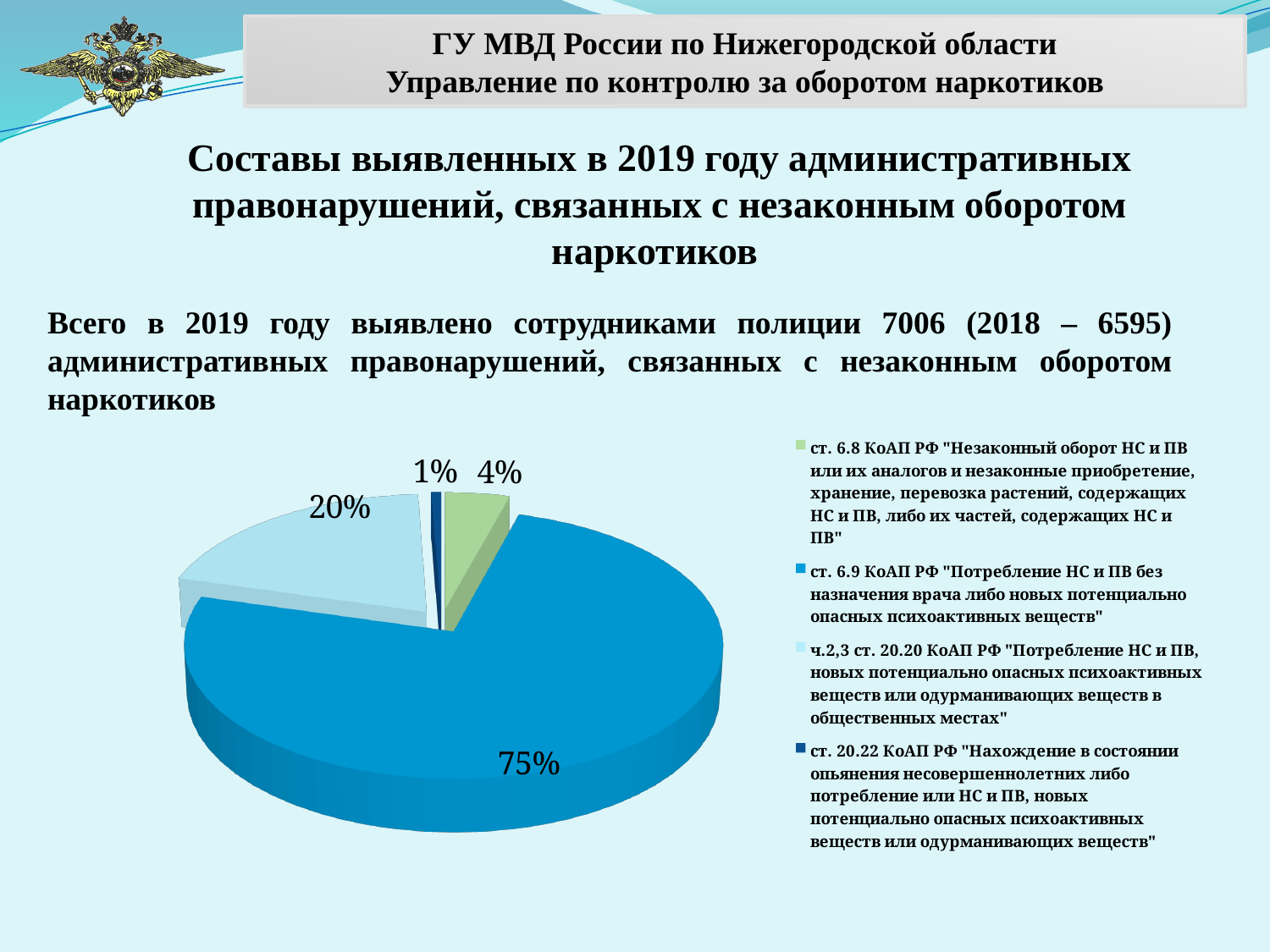
How many entries does the legend of the pie chart list? 4 How many slices does the pie chart have? 4 What colour is the slice representing ст. 6.8 КоАП РФ in the pie chart? Green What is the difference in percentage points between the slice for ст. 6.9 КоАП РФ and the slice for ч.2,3 ст. 20.20 КоАП РФ? 55 percentage points What share of the pie does ст. 6.9 КоАП РФ (Потребление НС и ПВ без назначения врача) account for? 75% Which slice is larger: ст. 6.8 КоАП РФ or ч.2,3 ст. 20.20 КоАП РФ? ч.2,3 ст. 20.20 КоАП РФ Which legend category has the largest slice of the pie? ст. 6.9 КоАП РФ "Потребление НС и ПВ без назначения врача либо новых потенциально опасных психоактивных веществ" What kind of chart is shown on the slide? Pie chart Which legend category has the smallest slice of the pie? ст. 20.22 КоАП РФ "Нахождение в состоянии опьянения несовершеннолетних..." What share of the pie does ст. 20.22 КоАП РФ account for? 1% What share of the pie does ст. 6.8 КоАП РФ account for? 4%